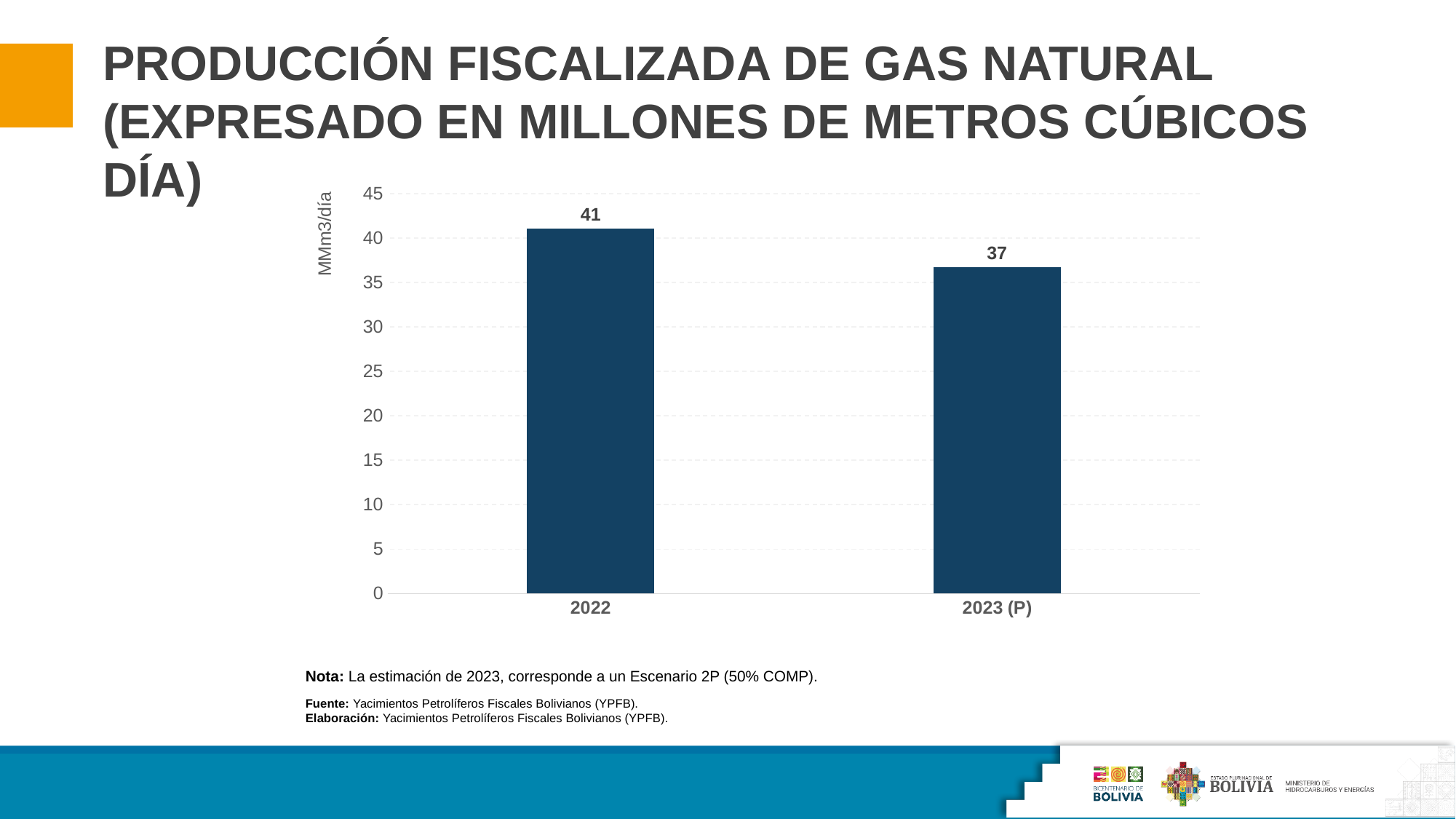
What kind of chart is shown on the slide? bar chart What is the label on the vertical axis of the chart? MMm3/día Which category has the lowest value? 2023 (P) Do the values rise or fall from 2022 to 2023 (P)? fall Which category has the highest value? 2022 What is the difference between the values for 2022 and 2023 (P)? 4 What is the value for 2023 (P)? 37 Is the value for 2022 greater or less than 40? greater What is the value for 2022? 41 How many categories are shown on the x axis? 2 Is the value for 2023 (P) greater or less than 40? less Which is larger, the value for 2022 or the value for 2023 (P)? 2022